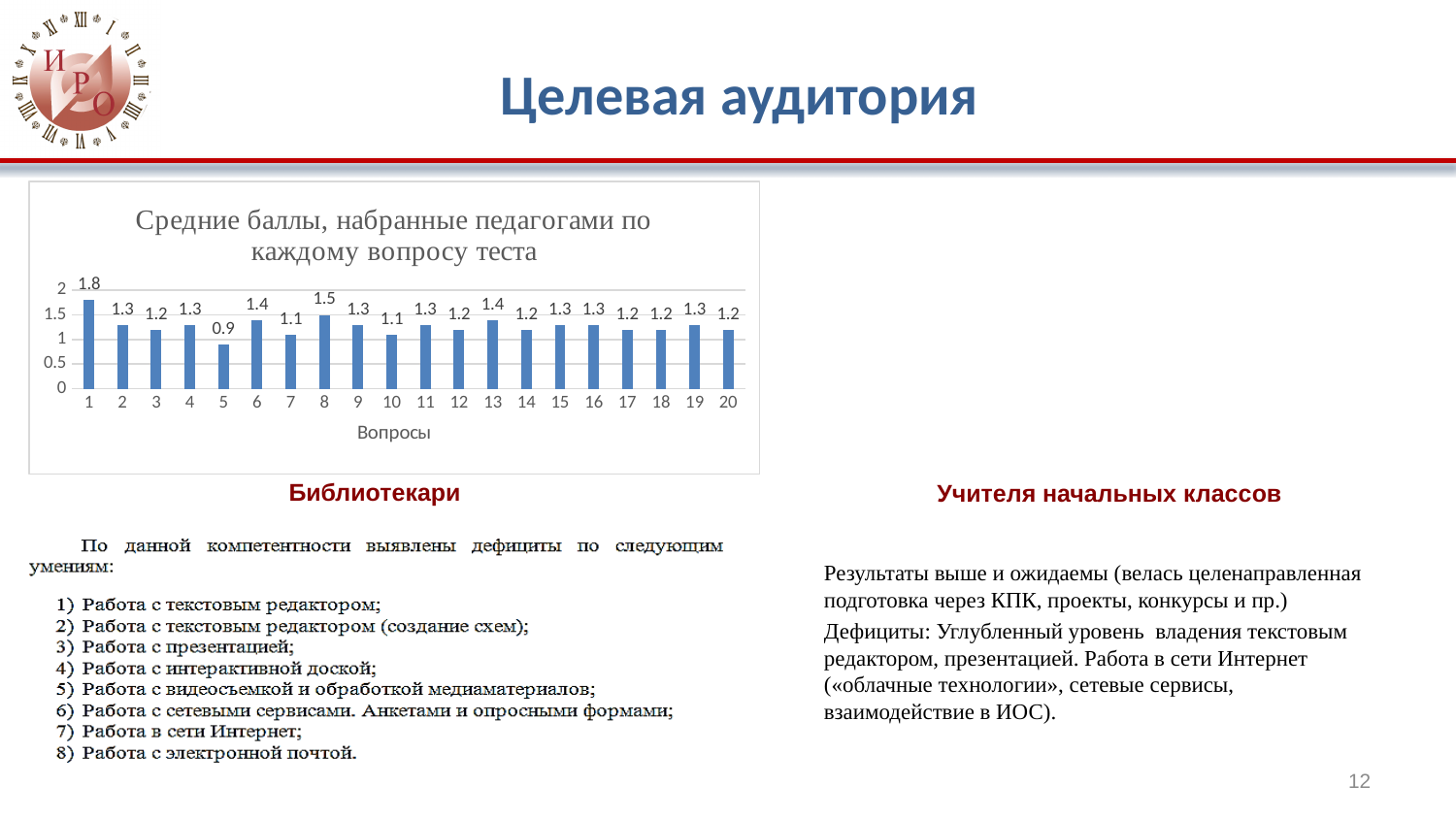
Which question has the lowest average score? 5 Which question has the highest average score? 1 Is the value for question 1 greater or less than 1.5? greater How many questions are shown on the x axis of the chart? 20 What is the average score for question 13? 1.4 What is the average score for question 1? 1.8 What is the difference between the average scores for question 1 and question 5? 0.9 What is the title of the chart? Средние баллы, набранные педагогами по каждому вопросу теста What is the average score for question 8? 1.5 What is the average score for question 5? 0.9 What type of chart is shown on the slide? Bar chart Which has a higher average score, question 6 or question 7? Question 6